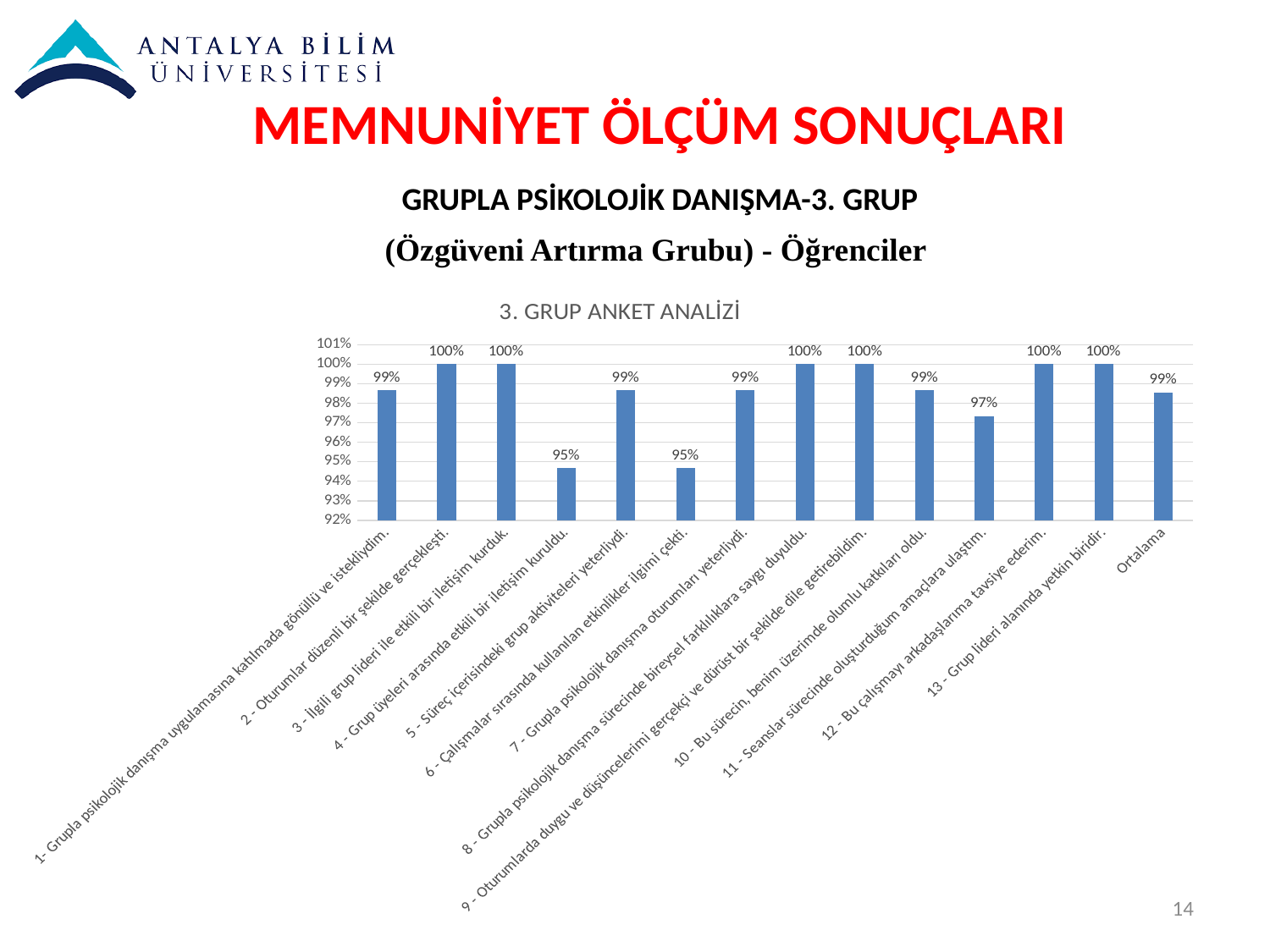
Is the value for '11 - Seanslar sürecinde oluşturduğum amaçlara ulaştım.' greater or less than 98%? less Which is larger: the value for '11 - Seanslar sürecinde oluşturduğum amaçlara ulaştım.' or the value for '4 - Grup üyeleri arasında etkili bir iletişim kuruldu.'? 11 - Seanslar sürecinde oluşturduğum amaçlara ulaştım. How many bars are plotted in the chart? 14 What is the value for 'Ortalama' in the chart? 99% What is the difference between the value for '3 - İlgili grup lideri ile etkili bir iletişim kurduk.' and the value for '6 - Çalışmalar sırasında kullanılan etkinlikler ilgimi çekti.'? 5% What is the title of the chart? 3. GRUP ANKET ANALİZİ What is the value for '2 - Oturumlar düzenli bir şekilde gerçekleşti.'? 100% Is the value for '6 - Çalışmalar sırasında kullanılan etkinlikler ilgimi çekti.' greater or less than 97%? less What is the value for '11 - Seanslar sürecinde oluşturduğum amaçlara ulaştım.'? 97% What is the value for '1- Grupla psikolojik danışma uygulamasına katılmada gönüllü ve istekliydim.'? 99% What is the value for '4 - Grup üyeleri arasında etkili bir iletişim kuruldu.'? 95% What kind of chart is shown on the slide? bar chart